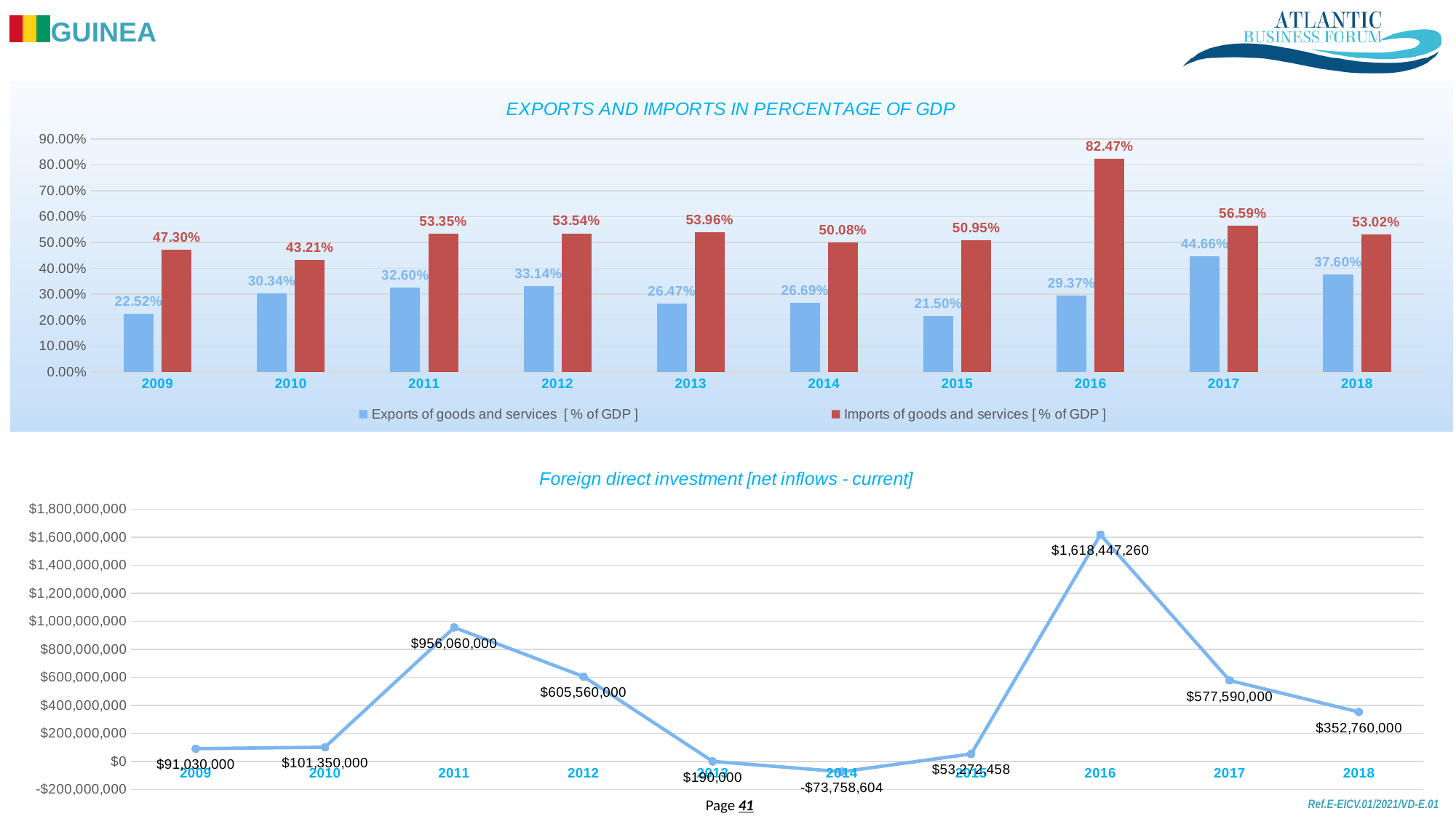
In the chart 'EXPORTS AND IMPORTS IN PERCENTAGE OF GDP', what is the value of exports of goods and services in 2017? 44.66% What kind of chart is 'Foreign direct investment [net inflows - current]'? line chart In the chart 'Foreign direct investment [net inflows - current]', what is the value for 2016? $1,618,447,260 What kind of chart is 'EXPORTS AND IMPORTS IN PERCENTAGE OF GDP'? bar chart In the chart 'Foreign direct investment [net inflows - current]', what is the difference between the 2011 and 2012 values? $350,500,000 In the chart 'EXPORTS AND IMPORTS IN PERCENTAGE OF GDP', which year has the larger exports value, 2011 or 2012? 2012 In the chart 'EXPORTS AND IMPORTS IN PERCENTAGE OF GDP', what is the value of imports of goods and services in 2016? 82.47% How many series does the legend of the chart 'EXPORTS AND IMPORTS IN PERCENTAGE OF GDP' list? 2 In the chart 'EXPORTS AND IMPORTS IN PERCENTAGE OF GDP', what is the difference between imports and exports in 2018? 15.42% In the chart 'EXPORTS AND IMPORTS IN PERCENTAGE OF GDP', which year has the lowest exports value? 2015 In the chart 'Foreign direct investment [net inflows - current]', which year has the lowest value? 2014 In the chart 'EXPORTS AND IMPORTS IN PERCENTAGE OF GDP', which year has the highest imports value? 2016